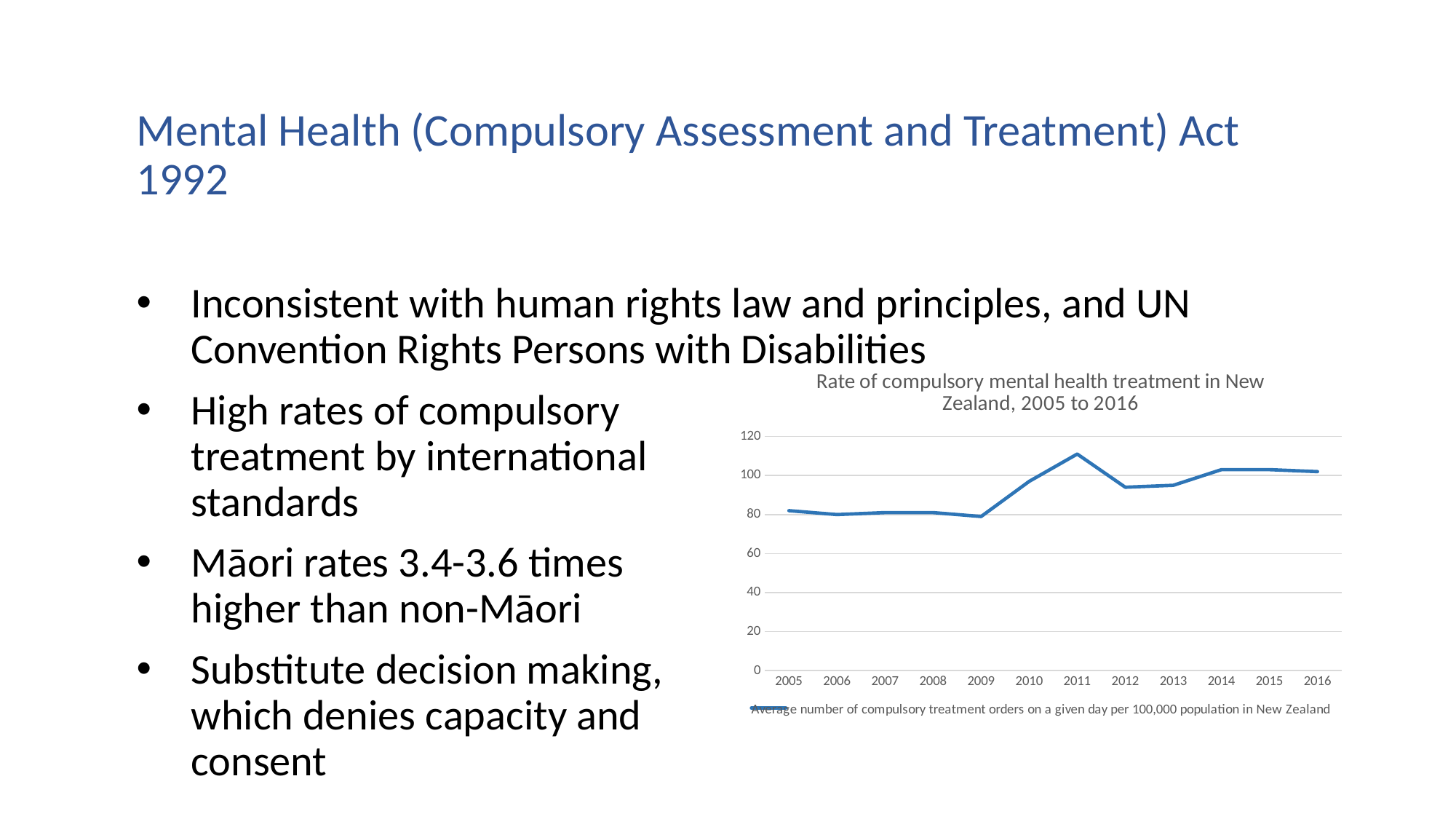
Is the value for 2011 greater or less than 100? greater What does the legend entry of the chart say? Average number of compulsory treatment orders on a given day per 100,000 population in New Zealand How many years are plotted along the x axis of the chart? 12 Is the value for 2005 greater or less than 100? less What is the title of the chart? Rate of compulsory mental health treatment in New Zealand, 2005 to 2016 Is the value for 2012 greater or less than 100? less Which year has the larger value, 2011 or 2009? 2011 How many series does the chart's legend list? 1 Which year has the highest rate of compulsory mental health treatment in the chart? 2011 Does the rate rise or fall between 2009 and 2011? rise What kind of chart is shown on the slide? line chart